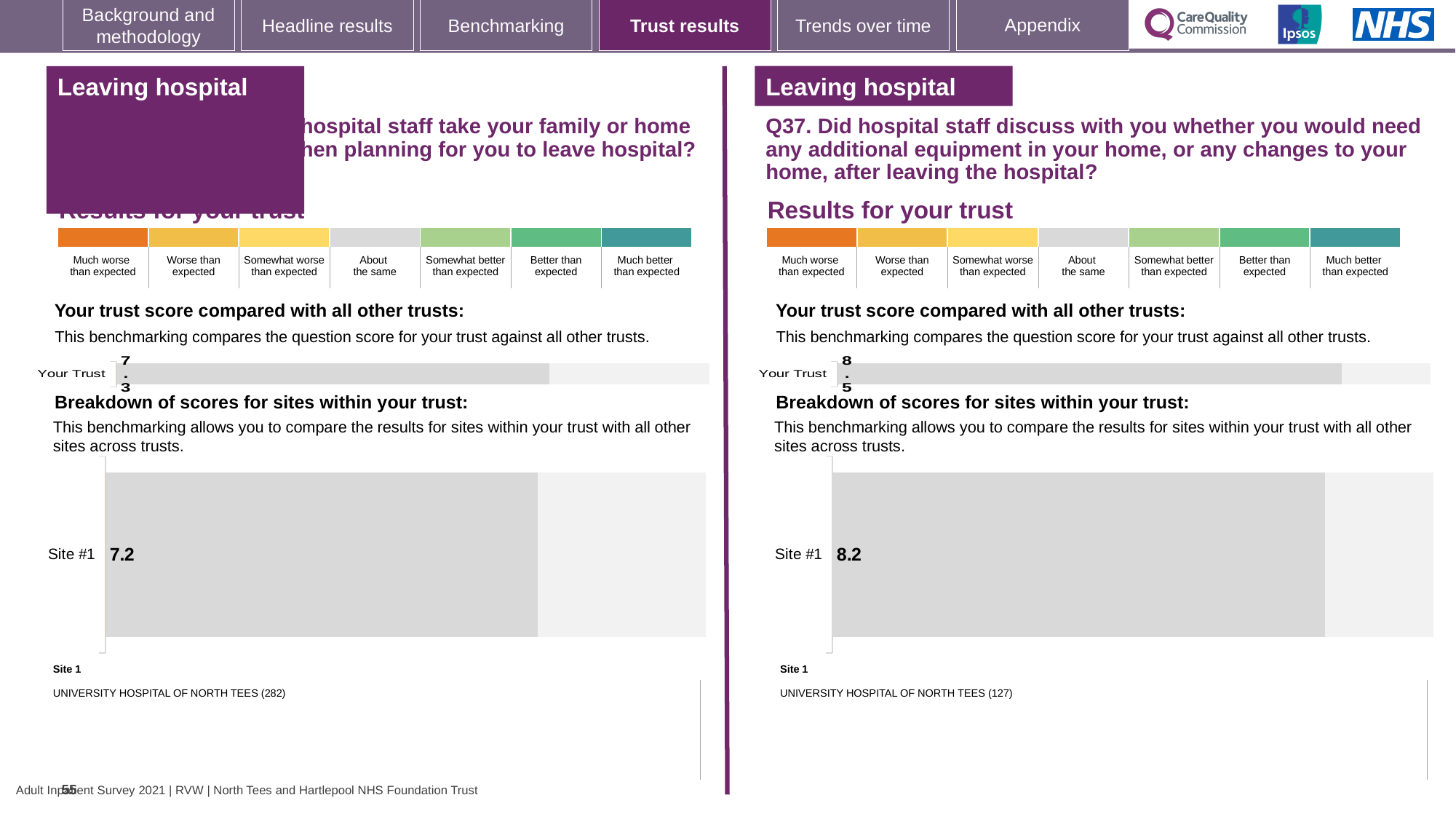
Which is larger: the Your Trust score on the left half of the slide or the Your Trust score on the right half (Q37)? Right half (Q37) How many sites are shown in the 'Breakdown of scores for sites within your trust' chart on the left half of the slide? 1 On the left half of the slide, what is the difference between the Your Trust score and the Site #1 score? 0.1 What is the difference between the Site #1 score on the right half of the slide (Q37) and the Site #1 score on the left half? 1.0 On the right half of the slide (Q37), what is the difference between the Your Trust score and the Site #1 score? 0.3 On the right half of the slide (Q37), what is the score shown for Your Trust in the 'Your trust score compared with all other trusts' chart? 8.5 On the right half of the slide (Q37), what score is shown for Site #1 in the 'Breakdown of scores for sites within your trust' chart? 8.2 Which site is listed as Site 1 beneath the charts on the right half of the slide? UNIVERSITY HOSPITAL OF NORTH TEES (127) On the left half of the slide, what score is shown for Site #1 in the 'Breakdown of scores for sites within your trust' chart? 7.2 On the left half of the slide, what is the score shown for Your Trust in the 'Your trust score compared with all other trusts' chart? 7.3 Which is larger: the Site #1 score on the left half of the slide or the Site #1 score on the right half (Q37)? Right half (Q37) What kind of chart is used to show the Site #1 score on the right half of the slide? Bar chart